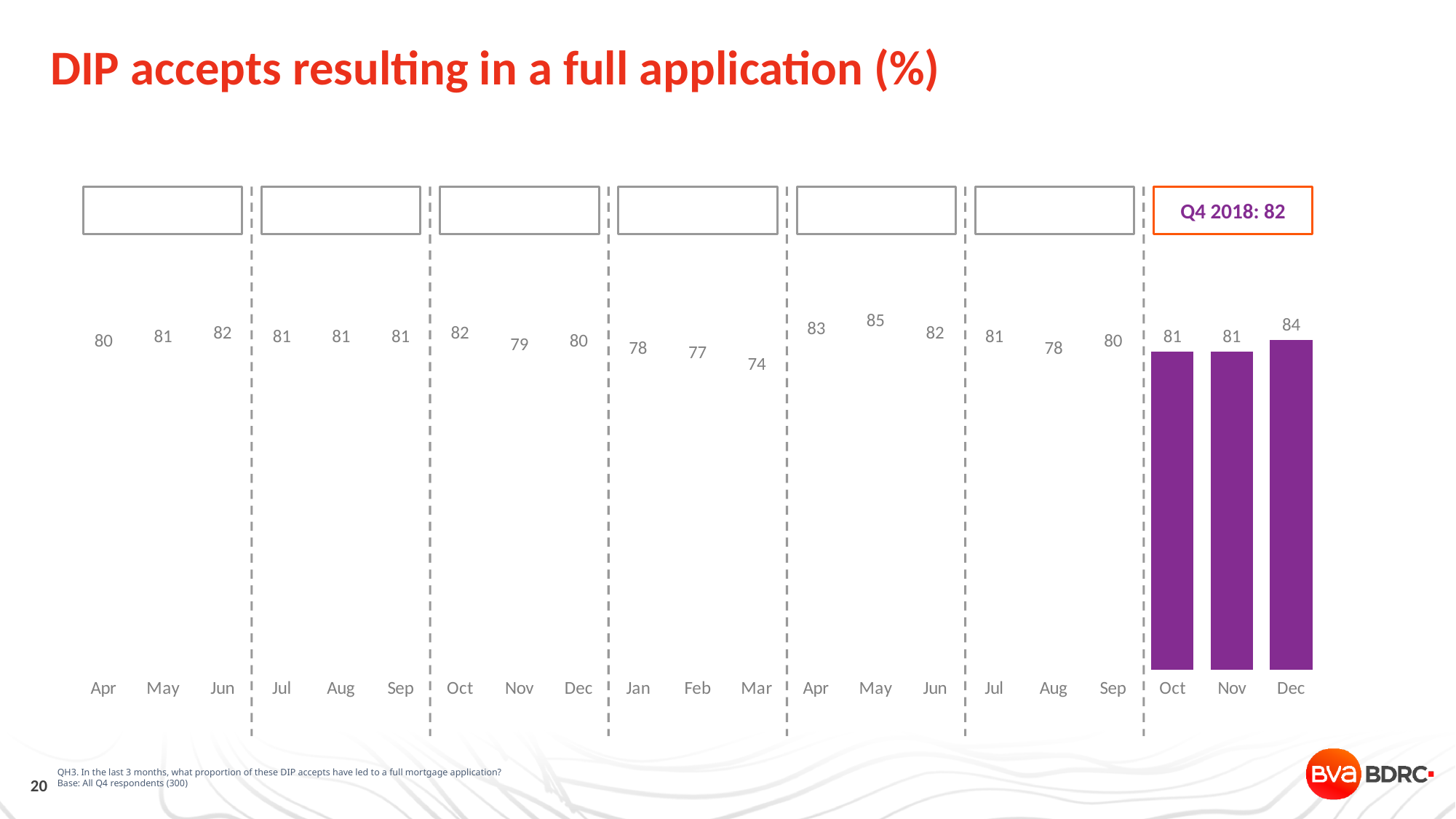
What is the title of the chart? DIP accepts resulting in a full application (%) What is the value for Oct in the Q4 2018 group (the first purple bar)? 81 What is the value for Mar, the last month of the Jan–Feb–Mar group? 74 Which month has the lowest value on the chart? Mar What is the highest value shown on the chart? 85 Which is larger: the value for Dec in the Q4 2018 group or the value for Nov in the Q4 2018 group? Dec What is the difference between the Dec value (84) and the Oct value (81) in the Q4 2018 group? 3 What value is shown in the Q4 2018 box above the purple bars? 82 How many monthly data points are shown on the chart? 21 What kind of chart is shown on the slide? bar chart What is the value for Dec in the Q4 2018 group (the last bar on the right)? 84 What is the value for Nov in the Q4 2018 group? 81